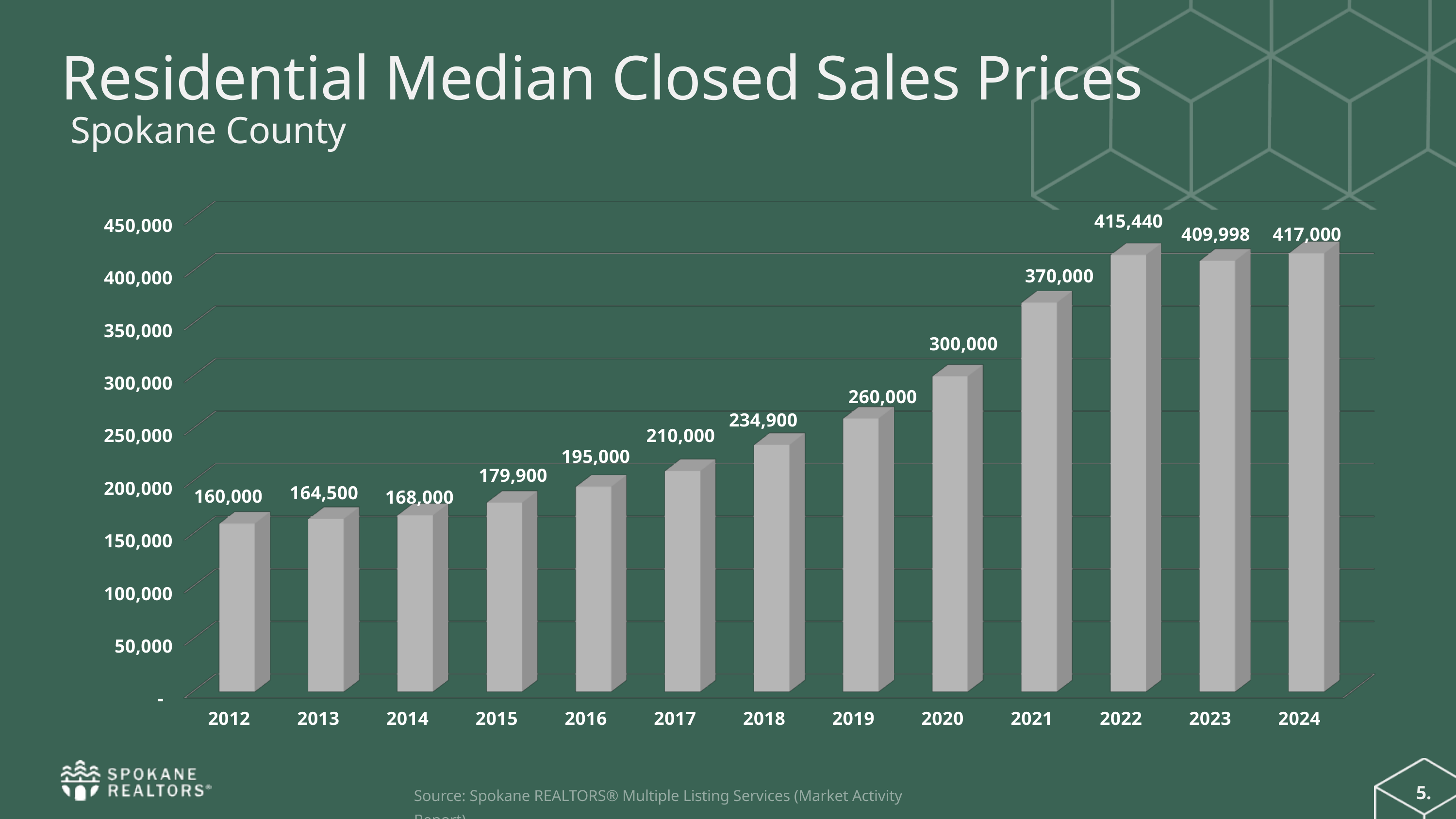
What is the residential median closed sales price for 2023? 409,998 What is the residential median closed sales price for 2018? 234,900 What kind of chart is shown on the slide? Bar chart How many years are shown on the x axis of the chart? 13 Do the median closed sales prices generally rise or fall from 2012 to 2024? Rise Which year has the highest median closed sales price? 2024 What is the difference between the median closed sales price in 2024 and in 2012? 257,000 Is the median closed sales price for 2019 greater or less than 250,000? greater What is the residential median closed sales price for 2012? 160,000 Which year has the lowest median closed sales price? 2012 Which year has a higher median closed sales price, 2022 or 2023? 2022 What is the difference between the median closed sales price in 2021 and in 2020? 70,000